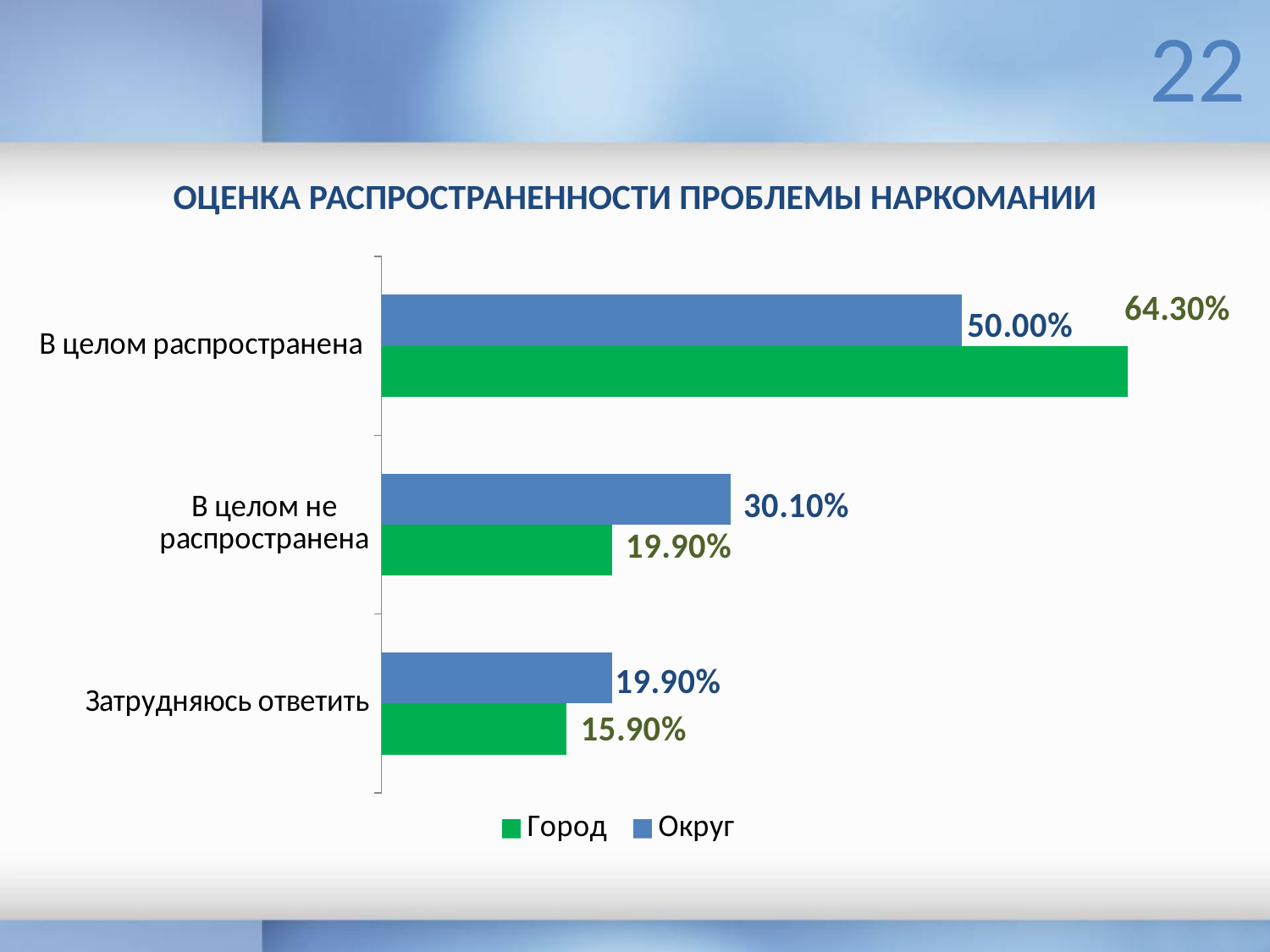
How many series does the legend list? 2 What is the value for Округ in the category 'В целом не распространена'? 30.10% What is the difference between the Город and Округ values for 'В целом распространена'? 14.30% What is the difference between the Округ and Город values for 'В целом не распространена'? 10.20% What is the value for Округ in the category 'В целом распространена'? 50.00% Which category has the lowest value for the Город series? Затрудняюсь ответить How many categories are shown on the chart? 3 Which category has the highest value for the Округ series? В целом распространена What is the value for Город in the category 'Затрудняюсь ответить'? 15.90% What is the value for Город in the category 'В целом распространена'? 64.30% Which is larger for 'Затрудняюсь ответить': the Город value or the Округ value? Округ What kind of chart is shown on the slide? Bar chart